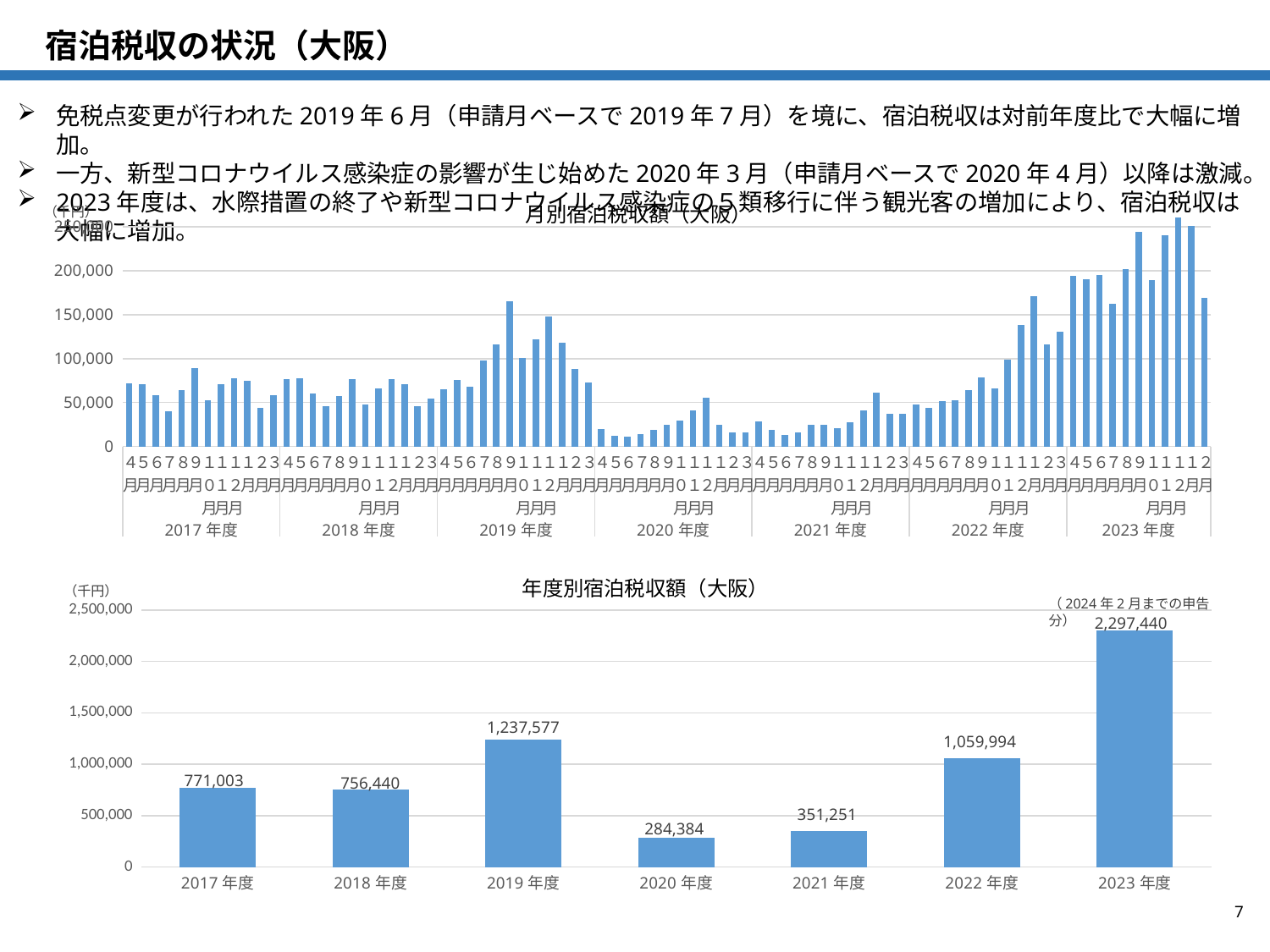
In the 年度別宿泊税収額（大阪） chart, which fiscal year has the highest value? 2023年度 In the 年度別宿泊税収額（大阪） chart, what is the difference between the values for 2023年度 and 2022年度? 1,237,446 How many fiscal years are shown in the 年度別宿泊税収額（大阪） chart? 7 What unit is shown on the vertical axis of the 年度別宿泊税収額（大阪） chart? 千円 In the 年度別宿泊税収額（大阪） chart, do the values rise or fall from 2020年度 to 2023年度? Rise In the 年度別宿泊税収額（大阪） chart, which fiscal year has the lowest value? 2020年度 In the 年度別宿泊税収額（大阪） chart, what is the value for 2019年度? 1,237,577 In the 月別宿泊税収額（大阪） chart, is the highest monthly value in 2019年度 greater or less than 150,000? greater In the 年度別宿泊税収額（大阪） chart, which is larger, the value for 2017年度 or 2018年度? 2017年度 What kind of chart is the 年度別宿泊税収額（大阪） chart? Bar chart In the 年度別宿泊税収額（大阪） chart, what is the value for 2020年度? 284,384 In the 年度別宿泊税収額（大阪） chart, what is the difference between the values for 2019年度 and 2018年度? 481,137